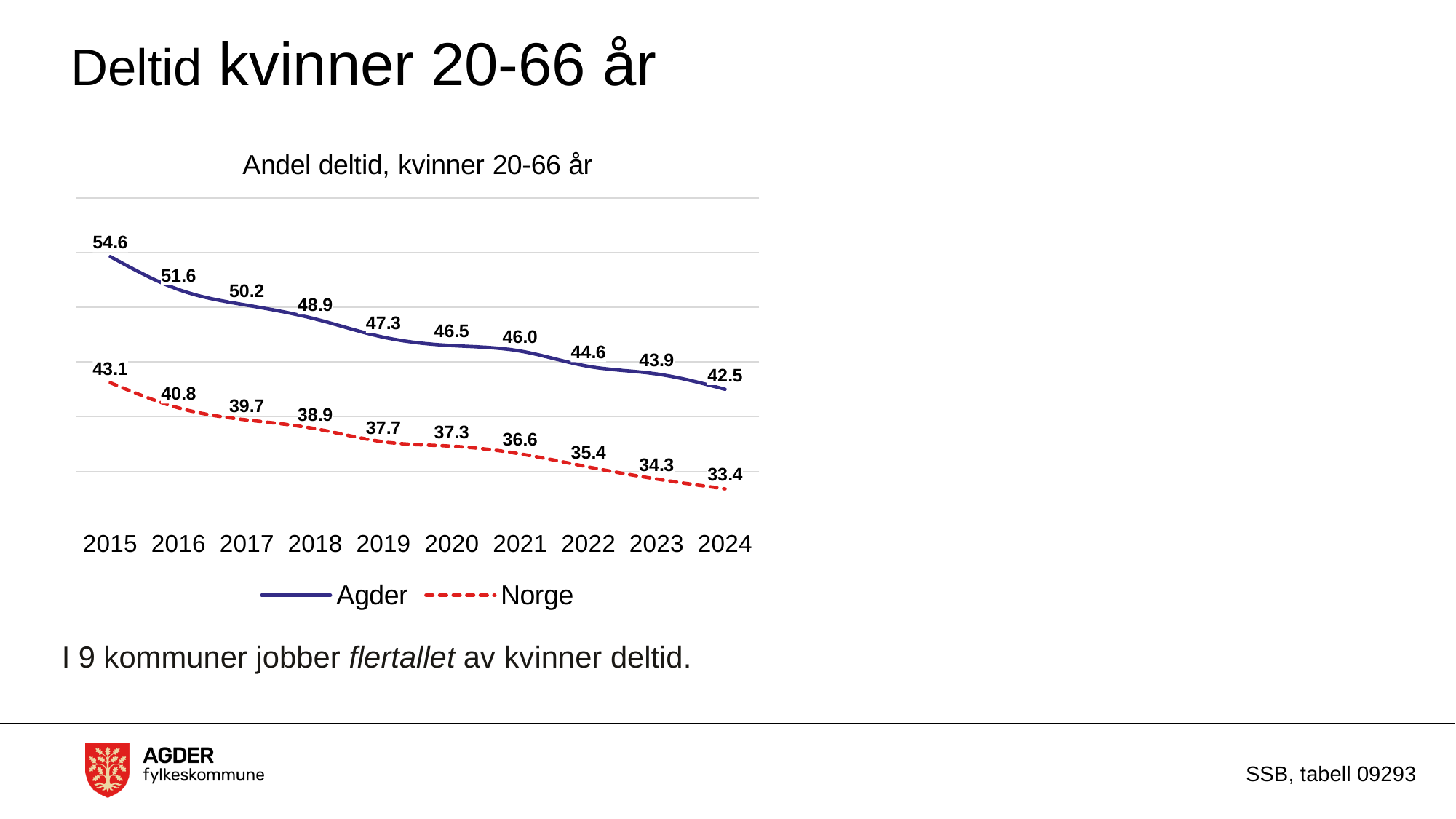
What kind of chart is shown on the slide? Line chart What is the value for Agder in 2015? 54.6 What is the value for Norge in 2024? 33.4 Do the values for Agder rise or fall from 2015 to 2024? Fall In which year is the Agder series at its lowest? 2024 In which year is the Norge series at its highest? 2015 What is the value for Norge in 2018? 38.9 How many series does the legend list? 2 What is the value for Agder in 2020? 46.5 What is the difference between Agder and Norge in 2024? 9.1 Which is larger in 2019, the value for Agder or the value for Norge? Agder How many years are shown on the x axis? 10